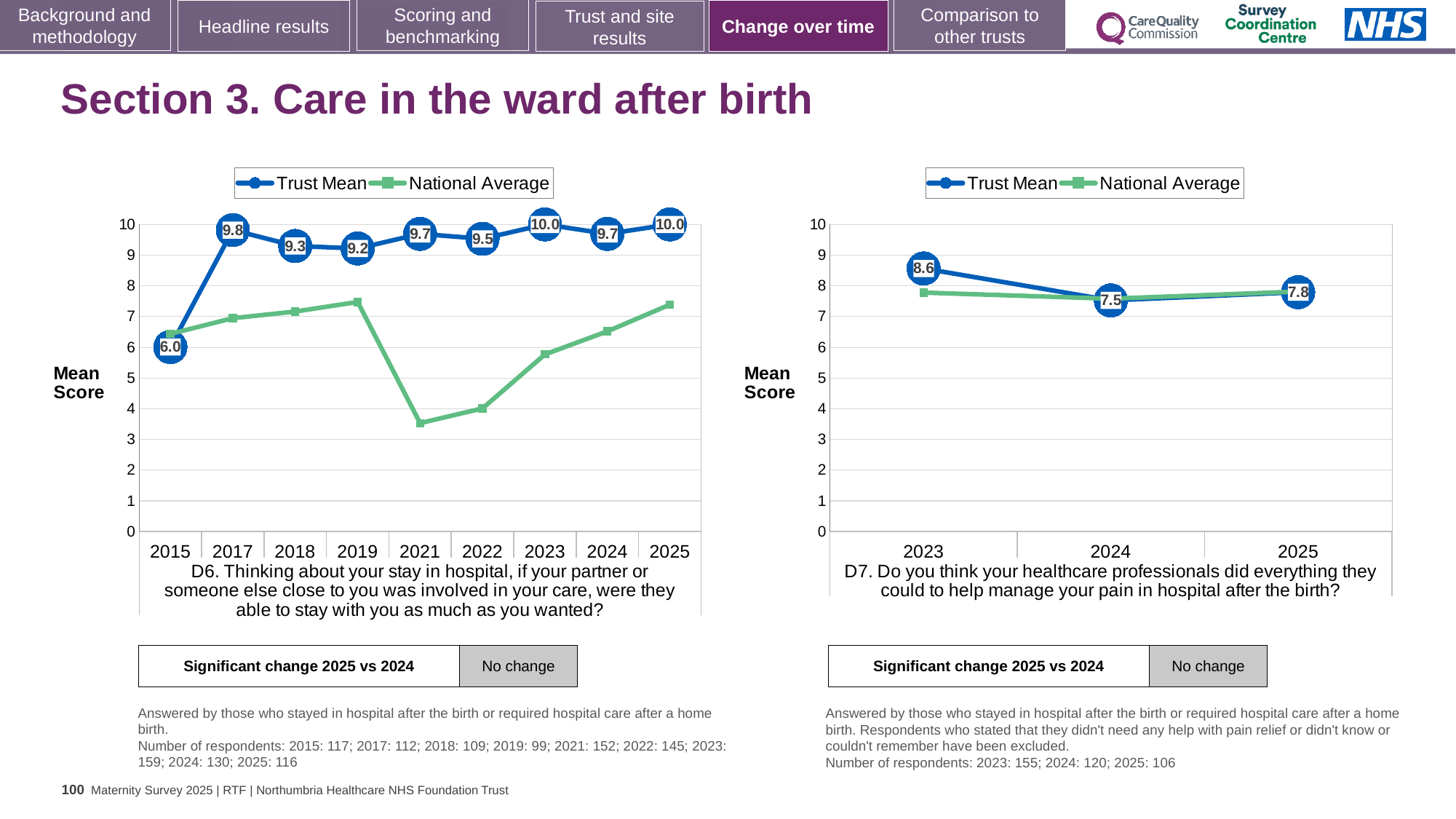
In the D7 chart on the right, what is the difference between the Trust Mean scores for 2023 and 2024? 1.1 In the D7 chart on the right, what is the Trust Mean score for 2023? 8.6 How many years are shown on the x axis of the D6 chart on the left? 9 What type of chart is the D6 chart on the left? Line chart In the D7 chart on the right, is the Trust Mean for 2025 larger or smaller than the Trust Mean for 2024? larger In the D6 chart on the left, which year has the lowest Trust Mean score? 2015 In the D6 chart on the left, what is the Trust Mean score for 2022? 9.5 In the D6 chart on the left, what is the Trust Mean score for 2015? 6.0 In the D6 chart on the left, is the National Average for 2021 greater or less than 5? less How many series does the legend of the D7 chart on the right list? 2 In the D7 chart on the right, which year has the highest Trust Mean score? 2023 In the D6 chart on the left, what is the difference between the Trust Mean scores for 2017 and 2015? 3.8